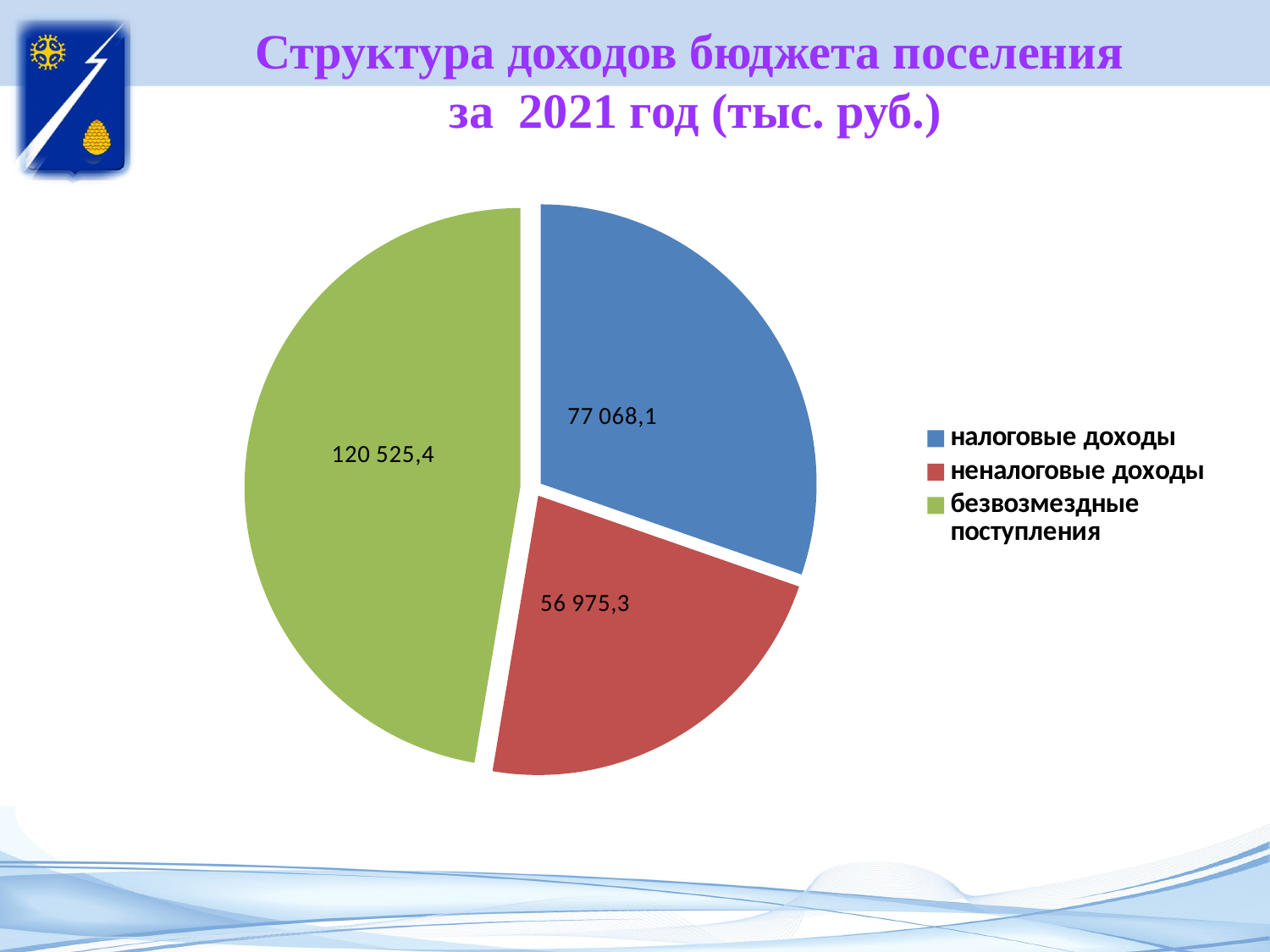
Which category has the largest slice of the pie? безвозмездные поступления How many categories does the pie chart show? 3 What colour is the slice for безвозмездные поступления? green Which is larger, налоговые доходы or неналоговые доходы? налоговые доходы What value is shown for неналоговые доходы? 56 975,3 Which category has the smallest slice of the pie? неналоговые доходы What value is shown for безвозмездные поступления? 120 525,4 What is the total of all three slices of the pie? 254 568,8 What kind of chart is shown on the slide? pie chart What is the difference between налоговые доходы and неналоговые доходы? 20 092,8 What is the difference between безвозмездные поступления and налоговые доходы? 43 457,3 What value is shown for налоговые доходы? 77 068,1